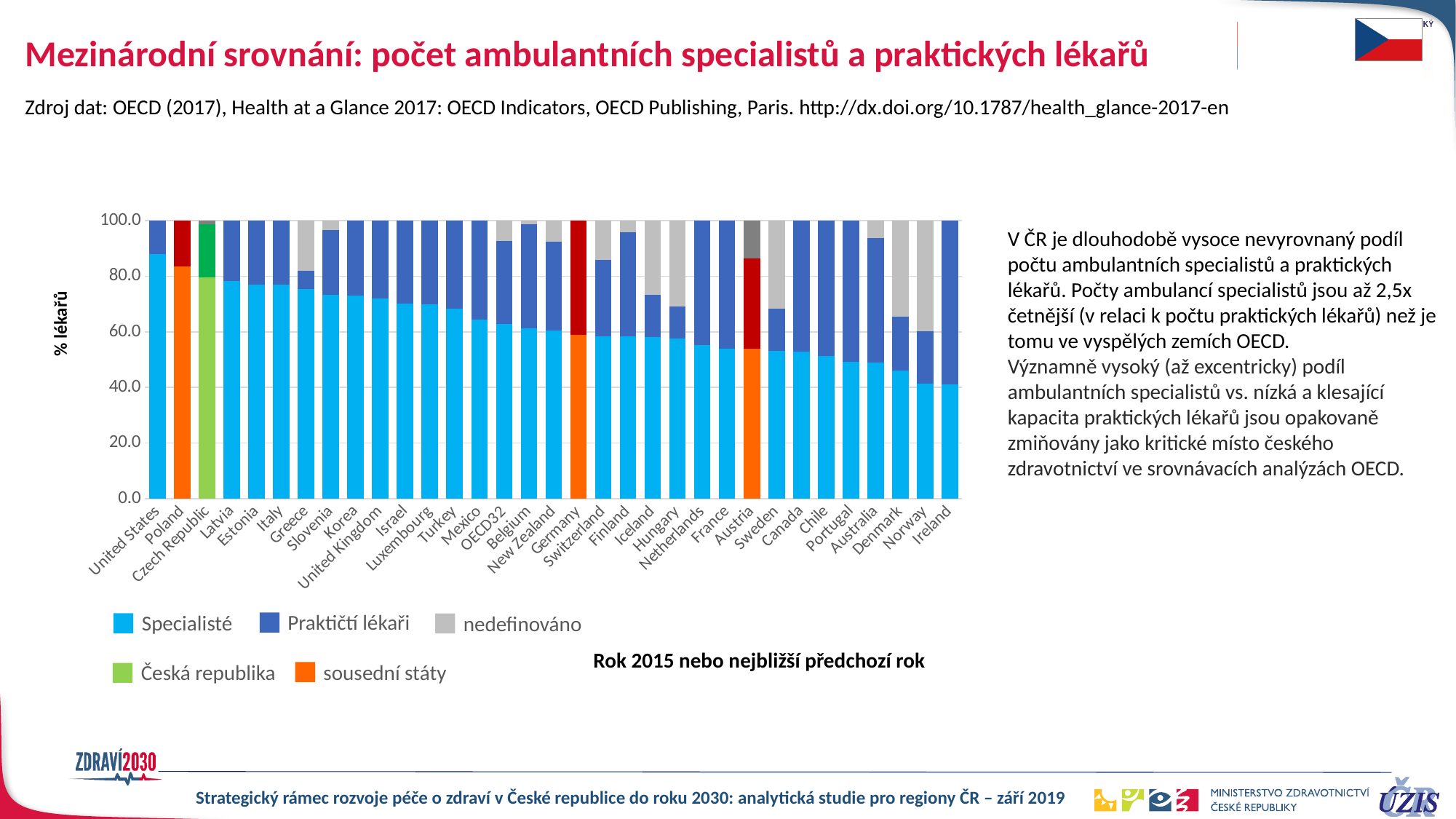
Is the Specialisté share for Czech Republic greater or less than 60? greater Does the Specialisté share rise or fall moving from left to right along the x axis? Fall What kind of chart is shown on the slide? Stacked bar chart What is the label of the y axis of the chart? % lékařů Which country has the highest share of Specialisté in the chart? United States Is the Specialisté share for United States greater or less than 80? greater How many countries or groups are shown along the x axis of the chart? 33 Is the Specialisté share for Ireland greater or less than 60? less How many entries does the chart legend list? 5 Which has a larger Specialisté share, United States or Ireland? United States Which legend entry is shown in green? Česká republika